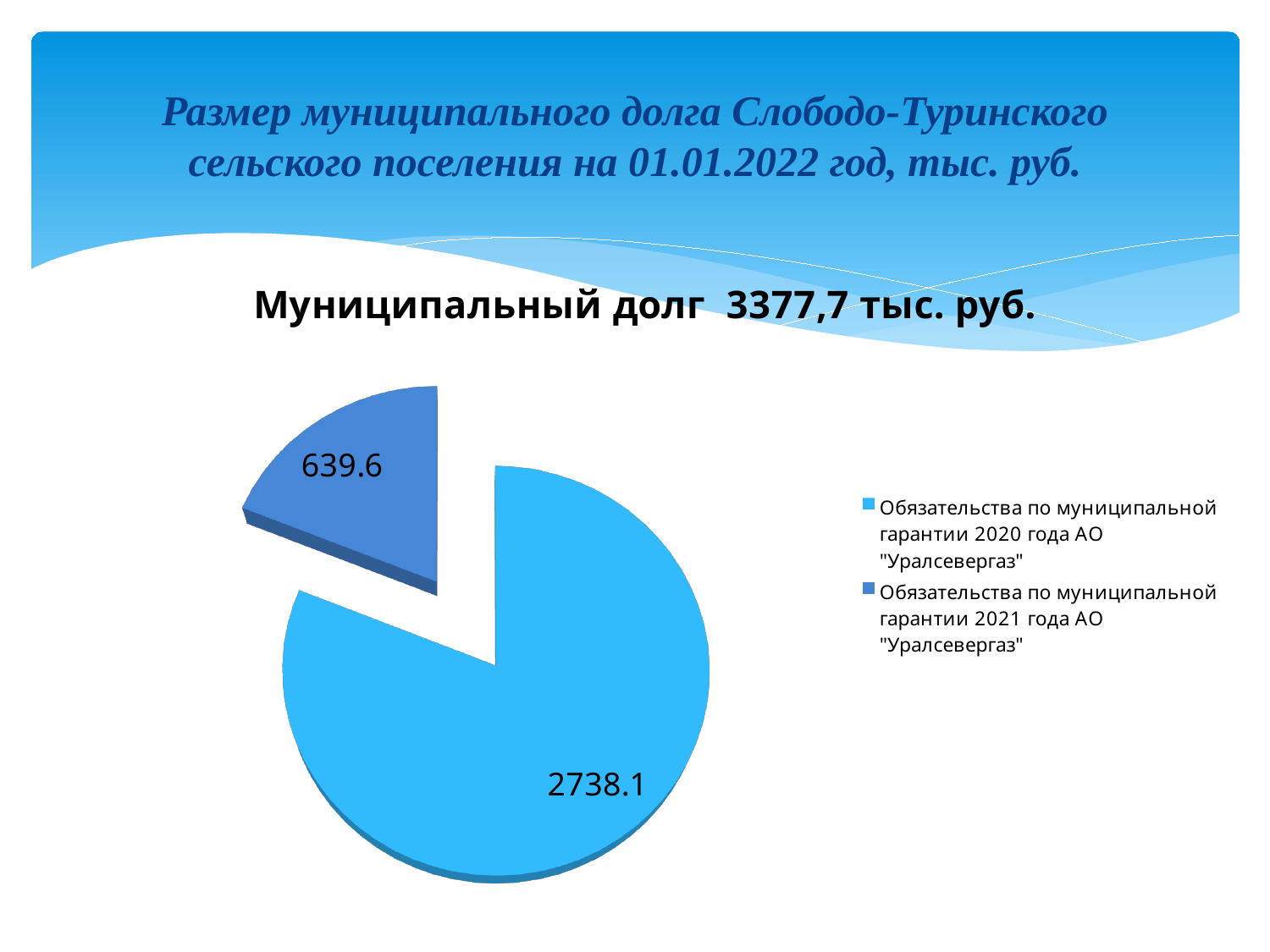
Which category has the smallest slice of the pie? Обязательства по муниципальной гарантии 2021 года АО "Уралсевергаз" How many slices does the pie chart have? 2 Which category has the largest slice of the pie? Обязательства по муниципальной гарантии 2020 года АО "Уралсевергаз" Which is larger: the 2020 guarantee obligations or the 2021 guarantee obligations? 2020 guarantee obligations What is the value of the slice for 'Обязательства по муниципальной гарантии 2021 года АО "Уралсевергаз"'? 639.6 What is the total of the two slices in the pie chart? 3377.7 What share of the pie does the 2021 guarantee obligations slice represent, to one decimal place? 18.9% What is the value of the slice for 'Обязательства по муниципальной гарантии 2020 года АО "Уралсевергаз"'? 2738.1 What total municipal debt is stated in the heading above the chart? 3377,7 тыс. руб. What is the difference between the 2020 guarantee obligations and the 2021 guarantee obligations? 2098.5 How many entries does the legend list? 2 What type of chart is shown on the slide? pie chart